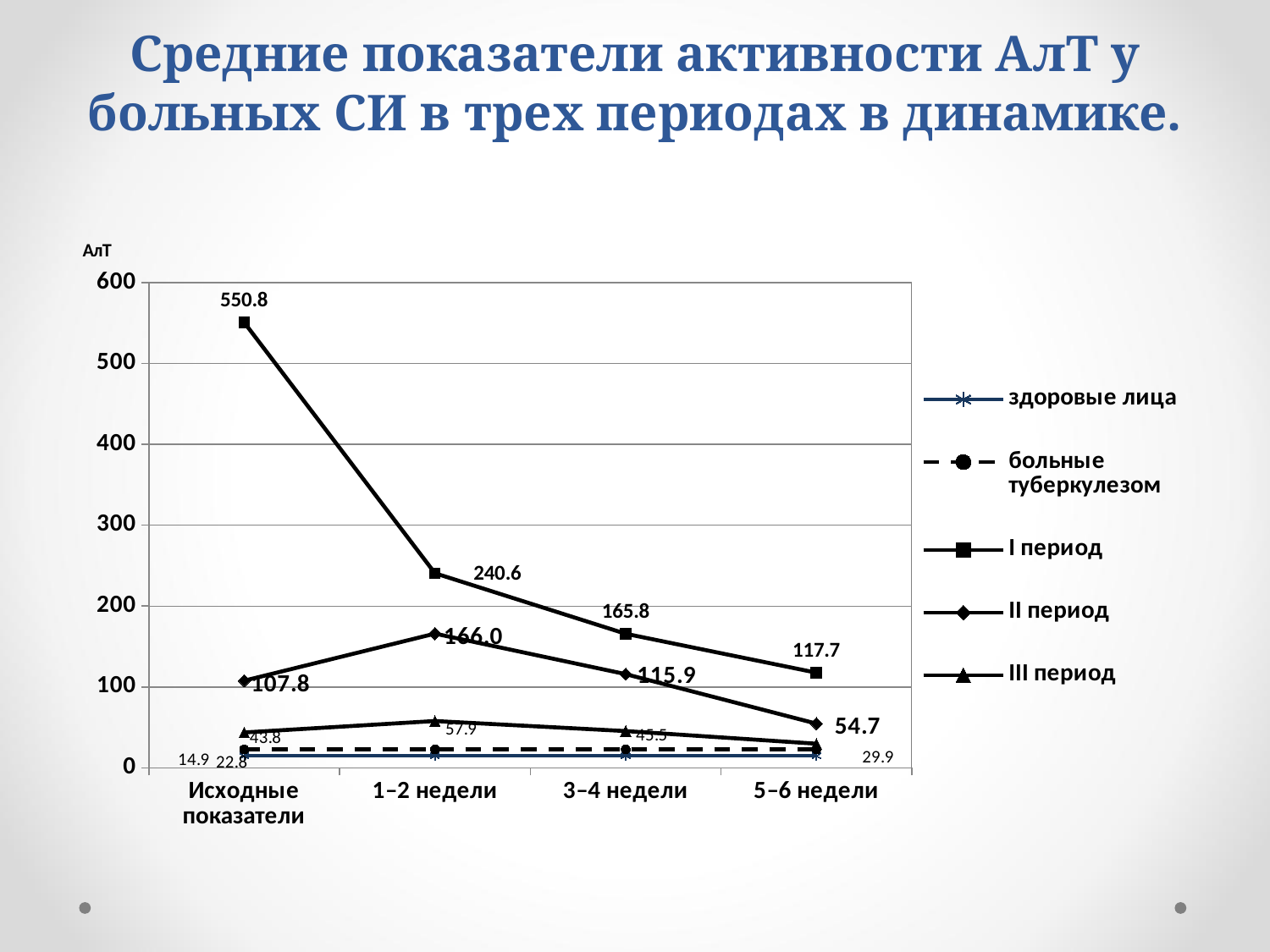
How many series does the legend list? 5 At which category does II период have its lowest value? 5–6 недели Does the value for I период rise or fall from Исходные показатели to 5–6 недели? fall What is the value for II период at 1–2 недели? 166.0 What is the value for I период at 5–6 недели? 117.7 What type of chart is shown on the slide? line chart What is the value for III период at 1–2 недели? 57.9 What is the value for I период at Исходные показатели? 550.8 Which is larger at 1–2 недели: I период or II период? I период How many categories are shown on the x axis? 4 At which category does I период reach its highest value? Исходные показатели What is the difference between I период and II период at 3–4 недели? 49.9